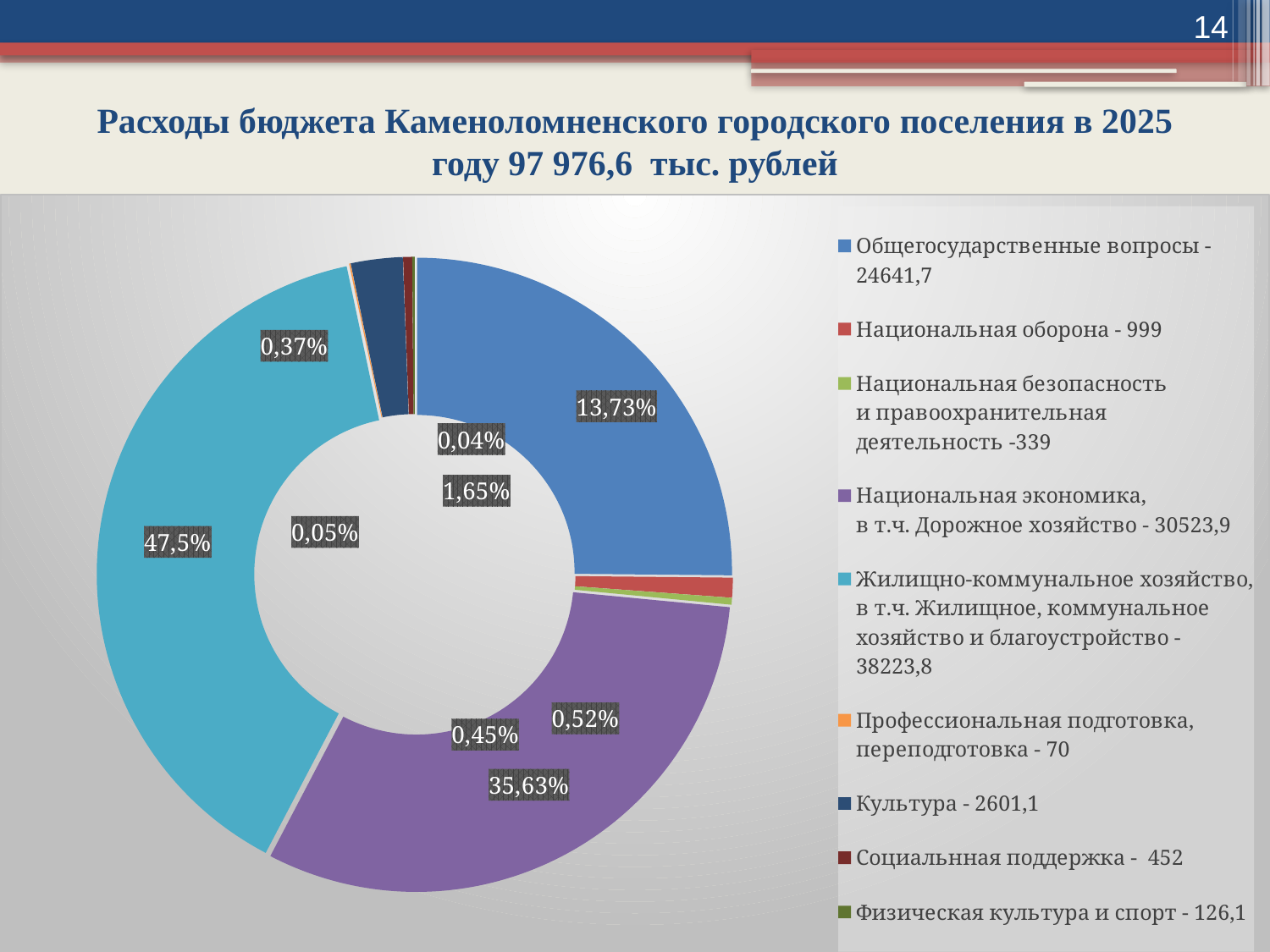
Which is larger according to the legend: Культура or Социальная поддержка? Культура What share of the pie does the largest slice (Жилищно-коммунальное хозяйство) take? 47,5% Which category has the largest value in the legend? Жилищно-коммунальное хозяйство (38223,8) According to the legend, what is the value for Национальная оборона? 999 What is the difference between the legend values for Жилищно-коммунальное хозяйство and Национальная экономика? 7699,9 Which category has the smallest value in the legend? Профессиональная подготовка, переподготовка (70) What total budget expenditure for 2025 is stated in the chart title? 97 976,6 тыс. рублей How many categories does the legend list? 9 According to the legend, what is the value for Общегосударственные вопросы? 24641,7 According to the legend, what is the value for Культура? 2601,1 What kind of chart is shown on the slide? Pie (doughnut) chart What share of the pie is labelled for the purple slice (Национальная экономика)? 35,63%